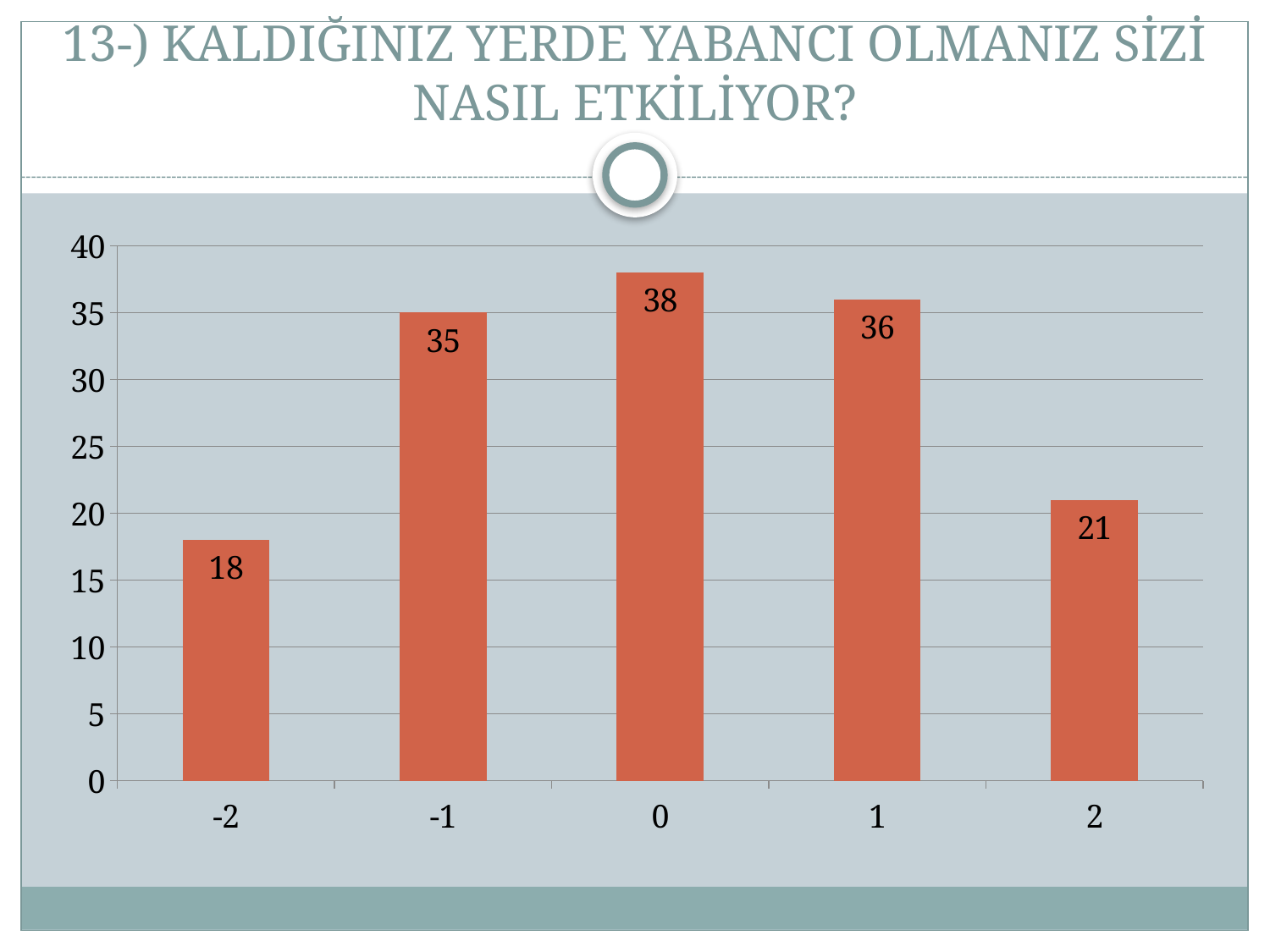
Is the value for -2 greater or less than 20? less How many categories are shown on the x axis? 5 Which is larger, the value for -1 or the value for 2? -1 What is the value for category -2? 18 What is the highest value shown on the y axis? 40 What is the difference between the values for 0 and -2? 20 What kind of chart is shown on the slide? bar chart Which category has the lowest value? -2 Which category has the highest value? 0 What is the value for category 2? 21 What is the difference between the values for 1 and 2? 15 What is the value for category 0? 38